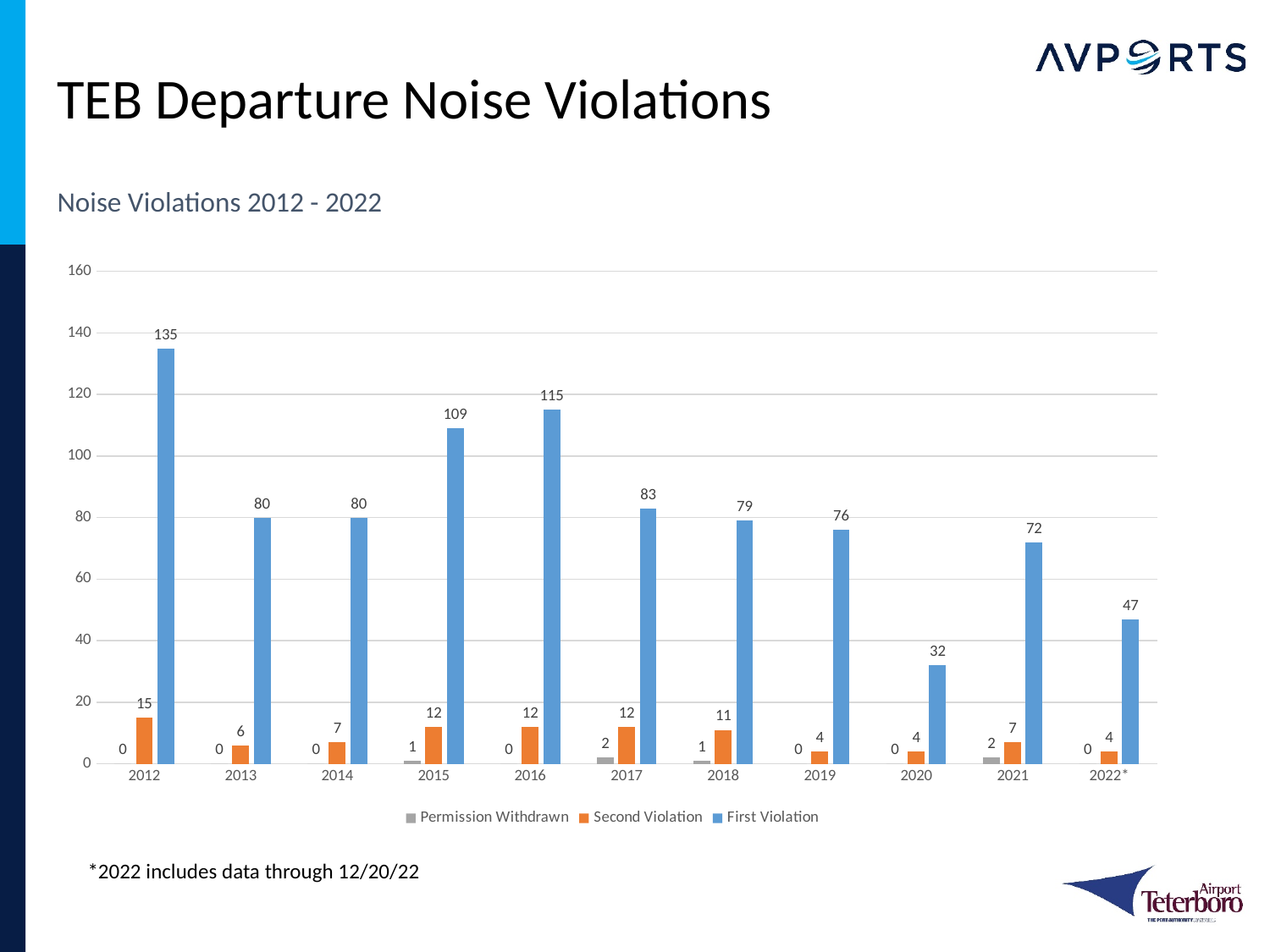
What is the Permission Withdrawn value for 2017? 2 What kind of chart is shown on the slide? Bar chart Which year has the highest First Violation value? 2012 What is the difference between the First Violation values for 2016 and 2015? 6 Do the First Violation values rise or fall from 2019 to 2020? Fall How many series does the legend list? 3 How many years are shown on the x axis? 11 What is the First Violation value for 2012? 135 Which is larger, the First Violation value for 2018 or for 2019? 2018 What is the Second Violation value for 2016? 12 Which year has the lowest First Violation value? 2020 What is the title of the chart? Noise Violations 2012 - 2022